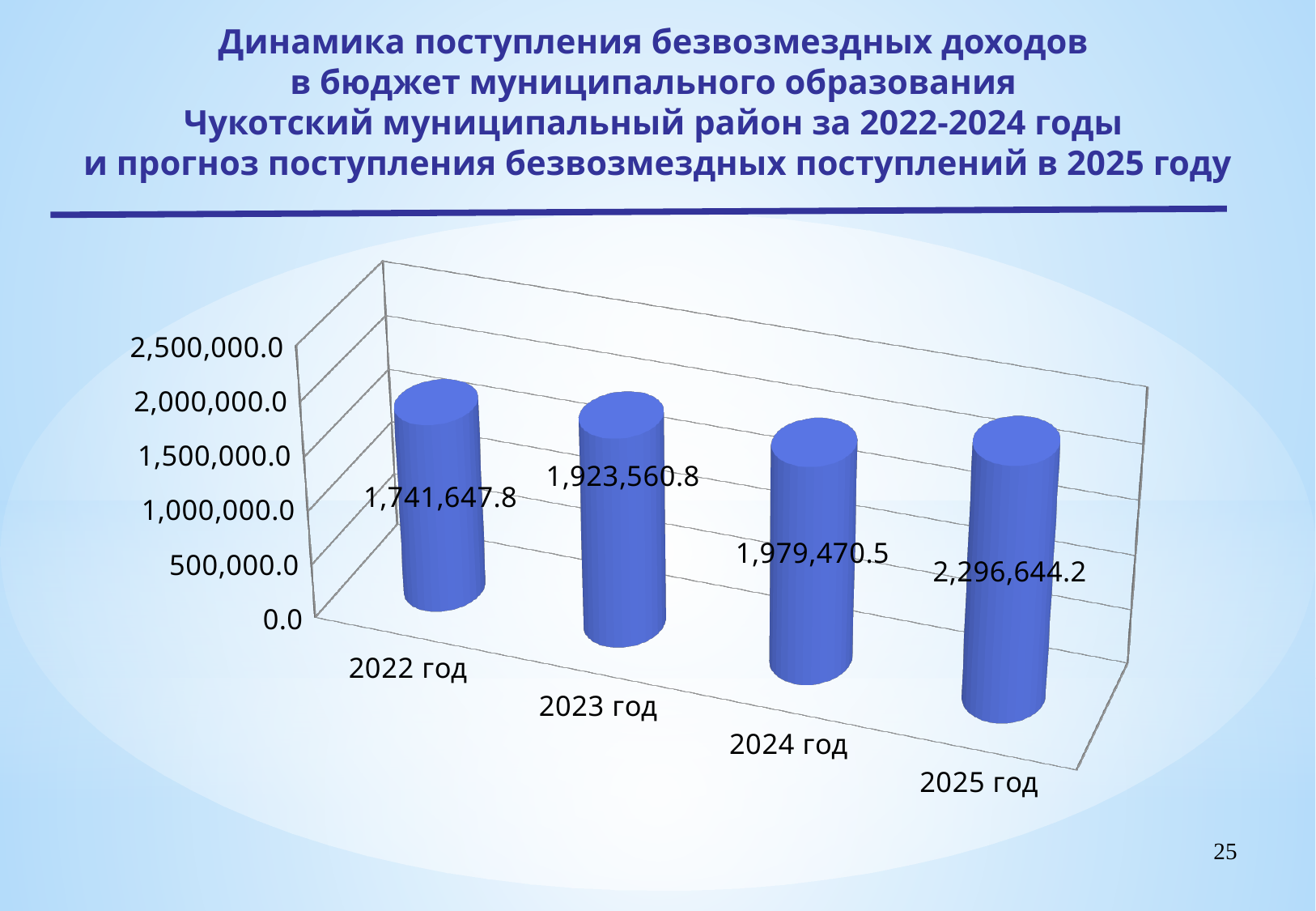
Which year has the lowest value? 2022 год What is the value for 2024 год? 1,979,470.5 Is the value for 2022 год greater or less than 2,000,000.0? less What is the difference between the values for 2023 год and 2022 год? 181,913.0 What is the difference between the values for 2025 год and 2024 год? 317,173.7 What is the value for 2025 год? 2,296,644.2 Do the values rise or fall from 2022 год to 2025 год? rise How many years are shown on the chart? 4 Which year has the highest value? 2025 год What is the value for 2022 год? 1,741,647.8 What is the value for 2023 год? 1,923,560.8 Which is larger, the value for 2023 год or the value for 2024 год? 2024 год